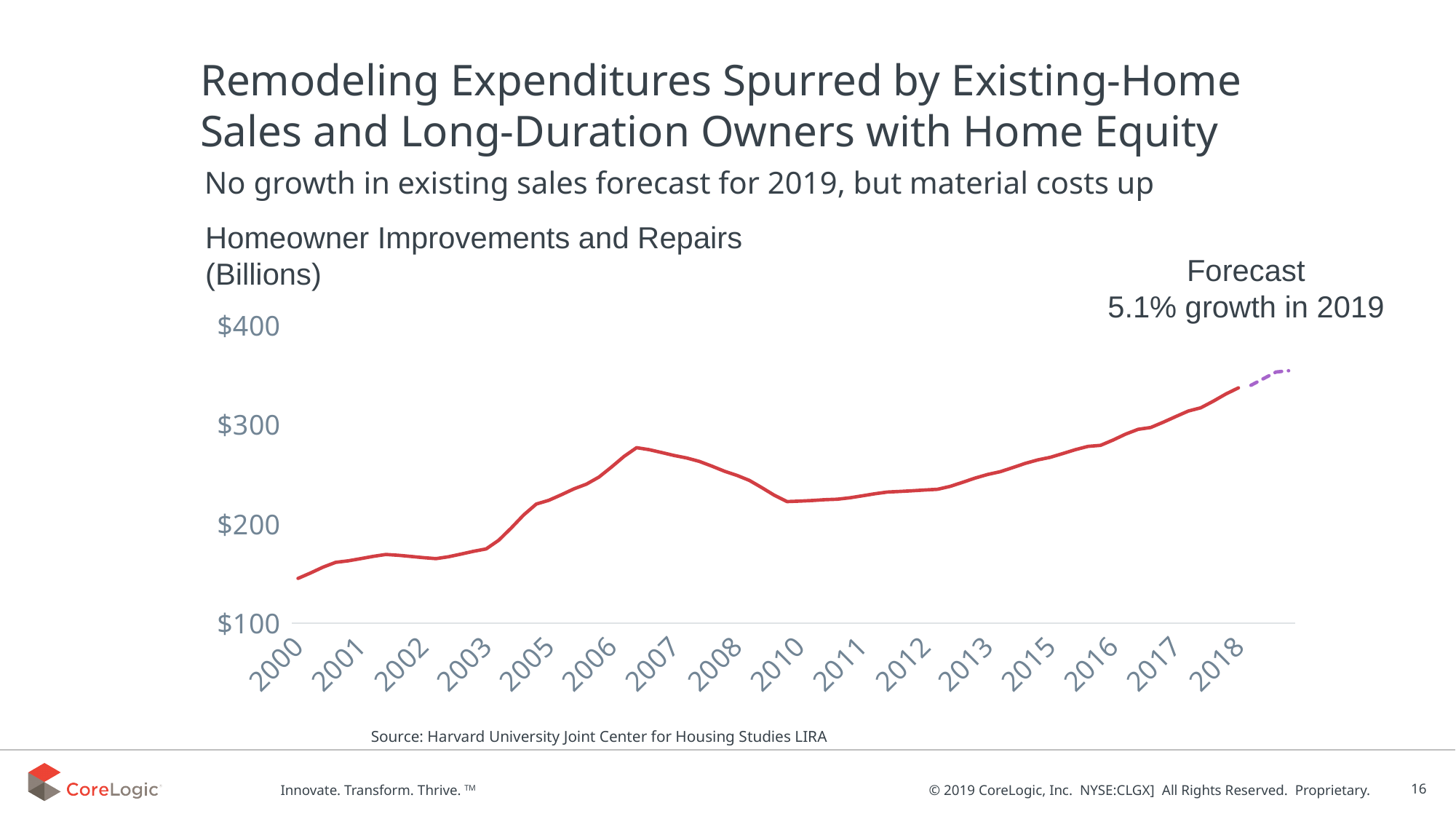
Is the value for 2007 greater or less than $300? less How many year labels are shown on the x axis? 16 What kind of chart is shown on the slide? line chart Which year has the lowest value on the line? 2000 What growth rate is forecast for 2019 according to the chart annotation? 5.1% Which year has the larger value, 2018 or 2007? 2018 Is the value for 2010 greater or less than $200? greater Which year has the larger value, 2007 or 2010? 2007 Which year has the highest value on the solid line? 2018 Do the values generally rise or fall from 2000 to 2018? rise Is the value for 2000 greater or less than $200? less